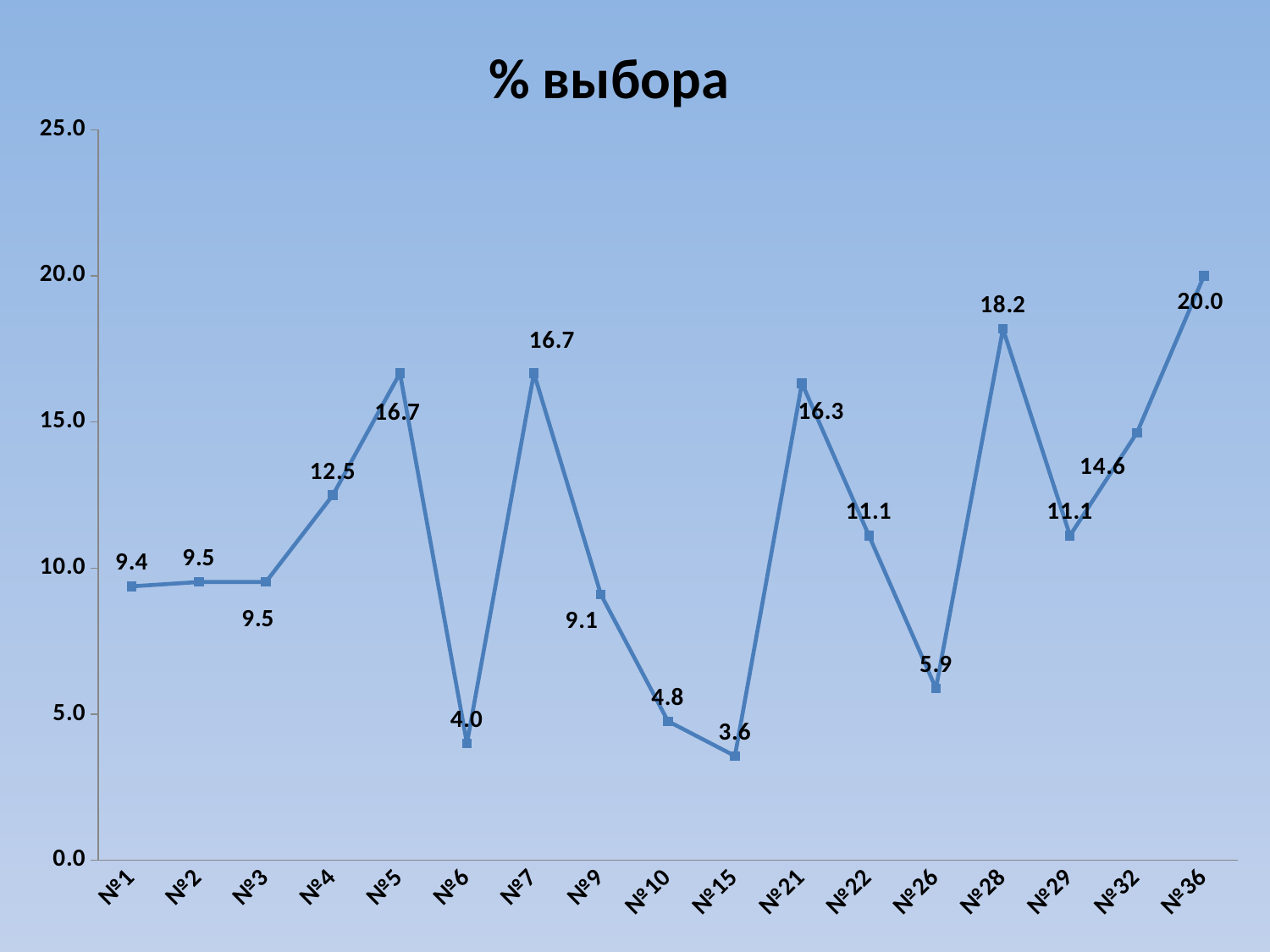
What is the difference between the values for №36 and №15? 16.4 What is the title of the chart? % выбора What is the difference between the values for №28 and №26? 12.3 What kind of chart is shown on the slide? line chart Which category has the lowest value? №15 What is the value for №28? 18.2 What is the value for №6? 4.0 Is the value for №7 greater or less than 15.0? greater What is the value for №21? 16.3 Which is larger, the value for №4 or the value for №32? №32 Which category has the highest value? №36 How many categories are plotted on the x axis? 17